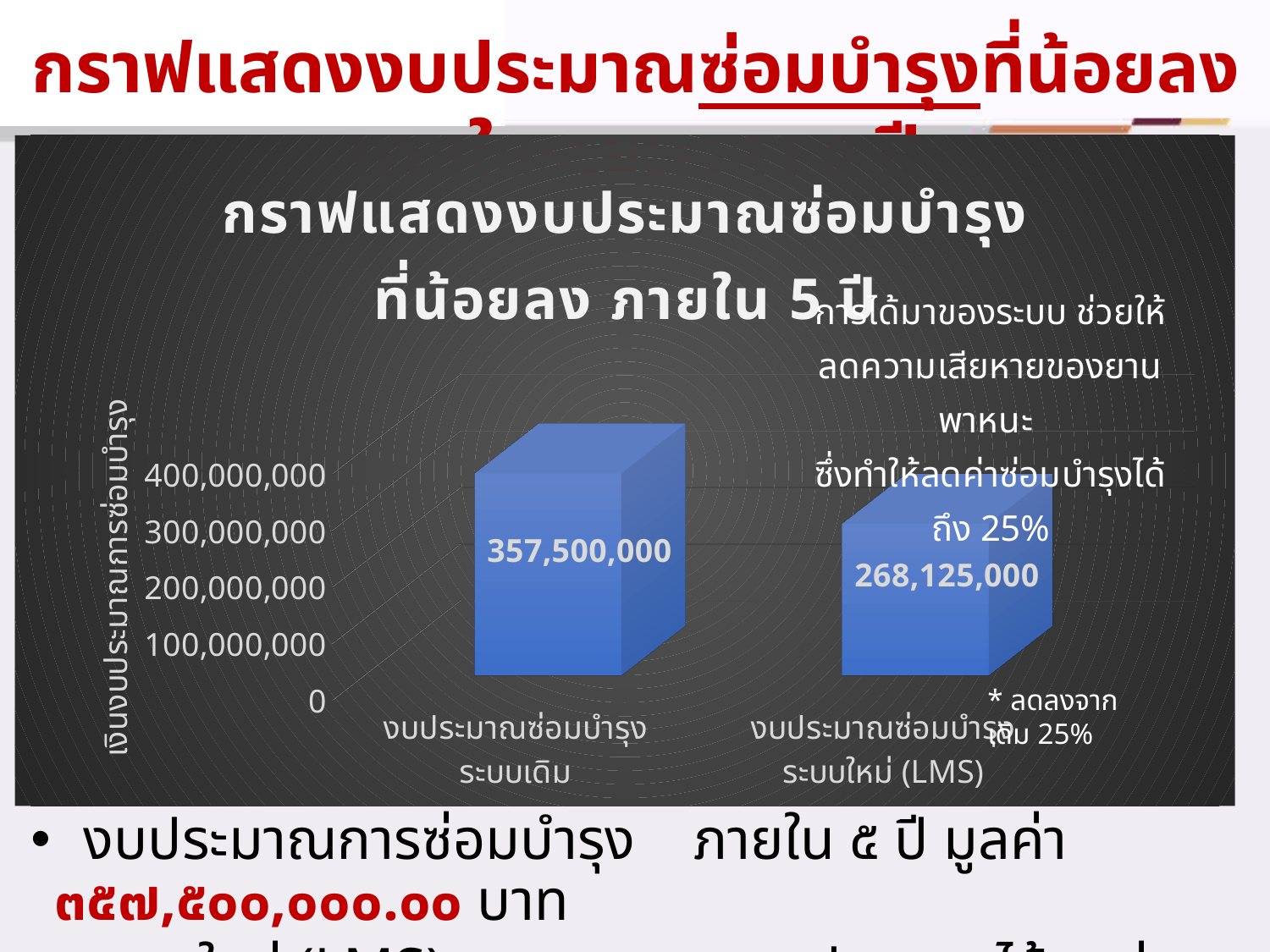
Is the value for งบประมาณซ่อมบำรุงระบบใหม่ (LMS) greater or less than 300,000,000? less What is the value for งบประมาณซ่อมบำรุงระบบเดิม? 357,500,000 What kind of chart is shown on the slide? bar chart What is the difference between the value for งบประมาณซ่อมบำรุงระบบเดิม and the value for งบประมาณซ่อมบำรุงระบบใหม่ (LMS)? 89,375,000 Do the values rise or fall from the left category to the right category? fall How many categories are shown in the chart? 2 Which is larger: the value for งบประมาณซ่อมบำรุงระบบเดิม or the value for งบประมาณซ่อมบำรุงระบบใหม่ (LMS)? งบประมาณซ่อมบำรุงระบบเดิม Which category has the highest value? งบประมาณซ่อมบำรุงระบบเดิม Is the value for งบประมาณซ่อมบำรุงระบบเดิม greater or less than 300,000,000? greater What is the title of the chart? กราฟแสดงงบประมาณซ่อมบำรุงที่น้อยลง ภายใน 5 ปี What is the value for งบประมาณซ่อมบำรุงระบบใหม่ (LMS)? 268,125,000 Which category has the lowest value? งบประมาณซ่อมบำรุงระบบใหม่ (LMS)